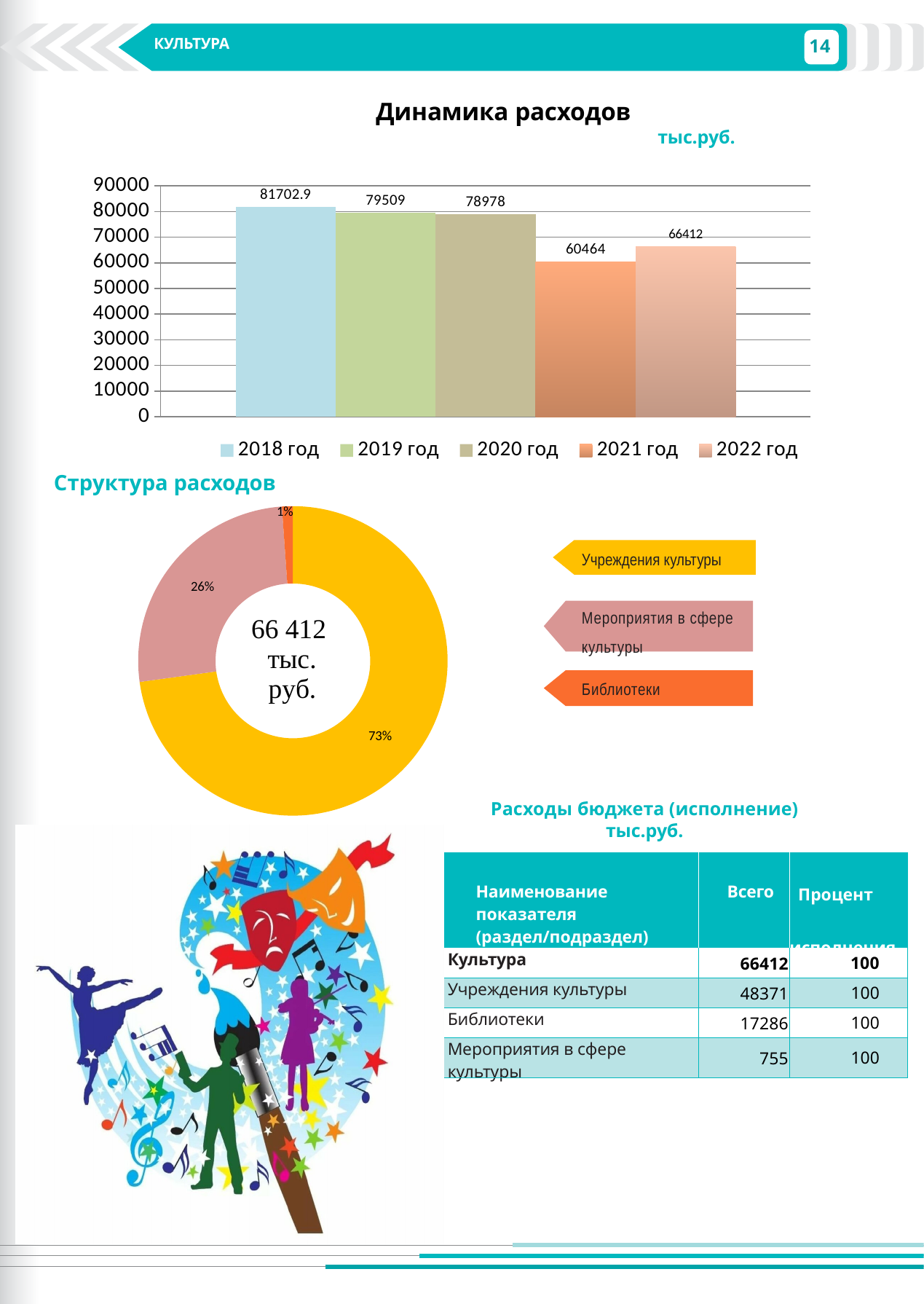
In the 'Динамика расходов' chart, which year has the highest value? 2018 год In the 'Динамика расходов' chart, how many years are shown? 5 In the 'Структура расходов' chart, what share does the 'Учреждения культуры' slice have? 73% In the 'Динамика расходов' chart, what is the difference between the values for 2019 год and 2020 год? 531 In the 'Структура расходов' chart, how many categories does the legend list? 3 In the 'Динамика расходов' chart, what is the value for 2021 год? 60464 In the 'Динамика расходов' chart, what is the value for 2022 год? 66412 In the 'Динамика расходов' chart, what is the value for 2018 год? 81702.9 What type of chart is 'Динамика расходов'? Bar chart In the 'Динамика расходов' chart, which is larger: the value for 2021 год or 2022 год? 2022 год In the 'Структура расходов' chart, what total is shown in the centre of the doughnut? 66 412 тыс. руб. In the 'Динамика расходов' chart, which year has the lowest value? 2021 год